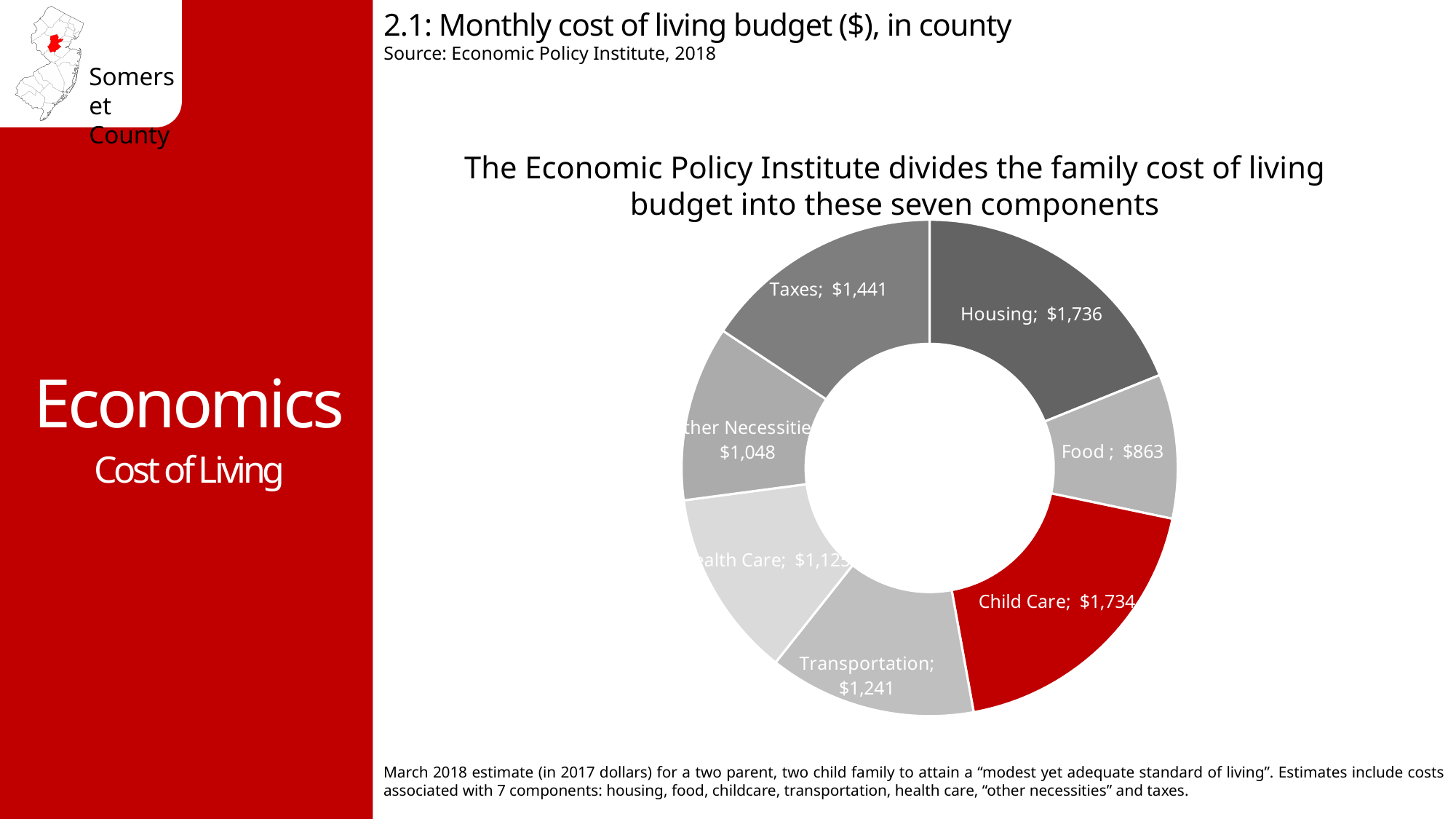
Which component has the lowest monthly cost in the chart? Food What is the monthly cost for Taxes in the chart? $1,441 What is the difference between the Housing cost and the Food cost? $873 Which is larger, the cost for Taxes or the cost for Transportation? Taxes What is the monthly cost for Other Necessities in the chart? $1,048 What is the monthly cost for Child Care in the chart? $1,734 What is the monthly cost for Housing in the chart? $1,736 What type of chart is shown on the slide? Doughnut (pie) chart What is the monthly cost for Transportation in the chart? $1,241 What is the monthly cost for Food in the chart? $863 How many components are shown in the chart? 7 What is the difference between the Taxes cost and the Transportation cost? $200